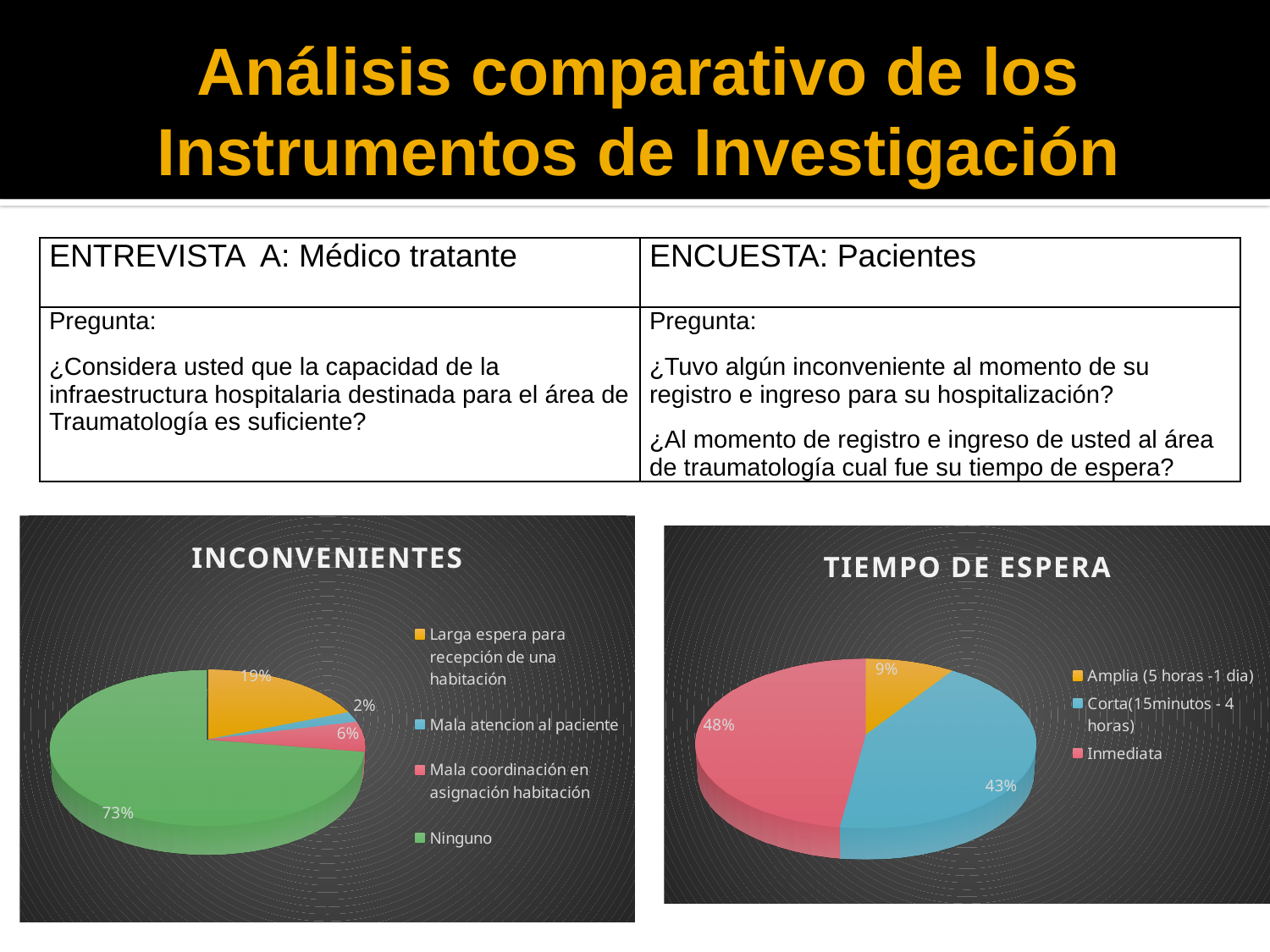
What type of chart is the TIEMPO DE ESPERA chart? Pie chart In the INCONVENIENTES chart, what percentage corresponds to Mala atencion al paciente? 2% In the TIEMPO DE ESPERA chart, which is larger, Amplia (5 horas -1 dia) or Inmediata? Inmediata In the INCONVENIENTES chart, what is the difference in percentage points between Larga espera para recepción de una habitación and Mala coordinación en asignación habitación? 13 In the INCONVENIENTES chart, which category has the smallest slice? Mala atencion al paciente In the INCONVENIENTES chart, what percentage corresponds to Larga espera para recepción de una habitación? 19% In the TIEMPO DE ESPERA chart, which category has the largest slice? Inmediata In the TIEMPO DE ESPERA chart, what is the difference in percentage points between Inmediata and Amplia (5 horas -1 dia)? 39 In the INCONVENIENTES chart, how many categories does the legend list? 4 In the INCONVENIENTES chart, what share of the pie is labelled Ninguno? 73% In the TIEMPO DE ESPERA chart, what percentage corresponds to Corta(15minutos - 4 horas)? 43% In the INCONVENIENTES chart, which category has the largest slice? Ninguno